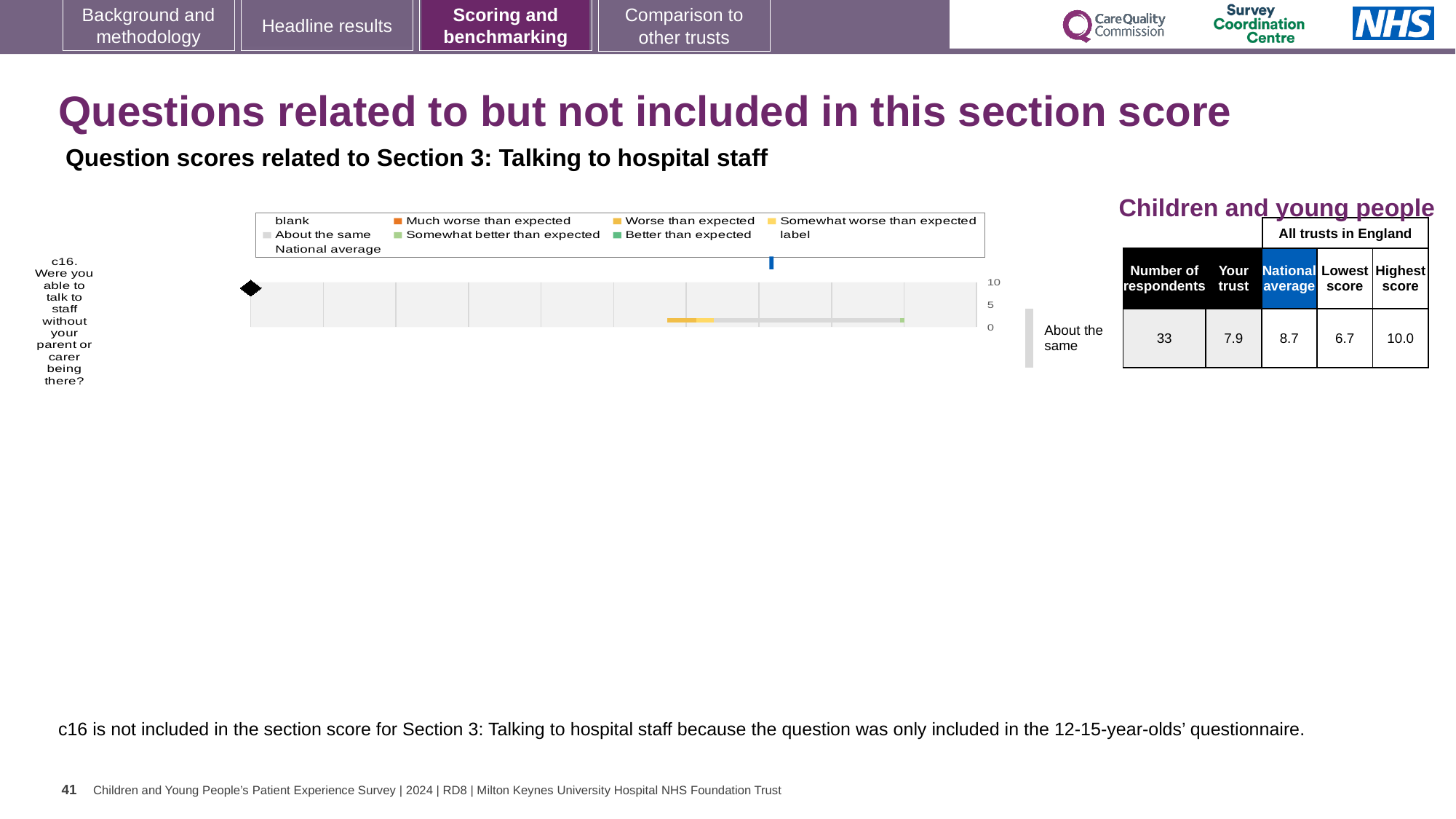
How many survey questions are plotted in the chart? 1 What benchmark category is c16 assigned to on the slide? About the same Which is larger for c16, the 'Your trust' score or the national average? National average What is the highest value shown on the chart's score axis? 10 What is the difference between the national average (8.7) and the 'Your trust' score (7.9) for c16? 0.8 According to the table beside the chart, what is the highest score among all trusts in England for c16? 10.0 According to the table beside the chart, what is the national average score for c16? 8.7 According to the table beside the chart, what is the 'Your trust' score for c16? 7.9 According to the table beside the chart, how many respondents answered c16? 33 Which question is plotted in the chart? c16. Were you able to talk to staff without your parent or carer being there? According to the table beside the chart, what is the lowest score among all trusts in England for c16? 6.7 What kind of chart is shown on the slide? bar chart